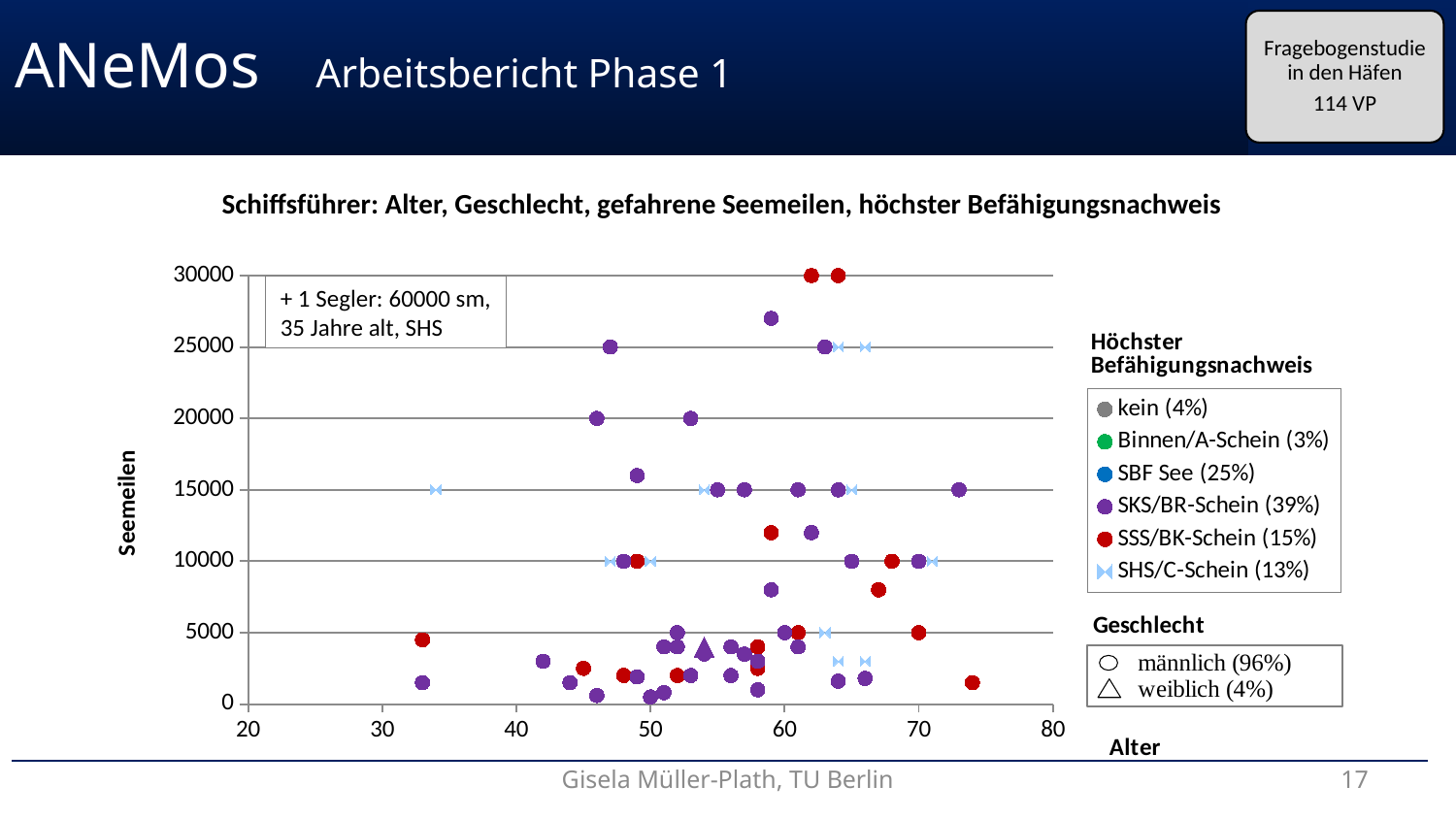
What kind of chart is shown on the slide? scatter plot What does the annotation box inside the chart say? + 1 Segler: 60000 sm, 35 Jahre alt, SHS What is the title of the chart? Schiffsführer: Alter, Geschlecht, gefahrene Seemeilen, höchster Befähigungsnachweis Which Befähigungsnachweis category has the lowest percentage in the legend? Binnen/A-Schein (3%) What is the difference in percentage points between SKS/BR-Schein and SBF See in the legend? 14 Which has the larger percentage in the legend, SSS/BK-Schein or SHS/C-Schein? SSS/BK-Schein What percentage is shown for SKS/BR-Schein in the legend? 39% How many categories does the 'Höchster Befähigungsnachweis' legend list? 6 What percentage is shown for SBF See in the legend? 25% Is the highest Seemeilen value plotted in the chart greater or less than 25000? greater What percentage of the Schiffsführer are männlich according to the Geschlecht legend? 96% Which Befähigungsnachweis category has the highest percentage in the legend? SKS/BR-Schein (39%)